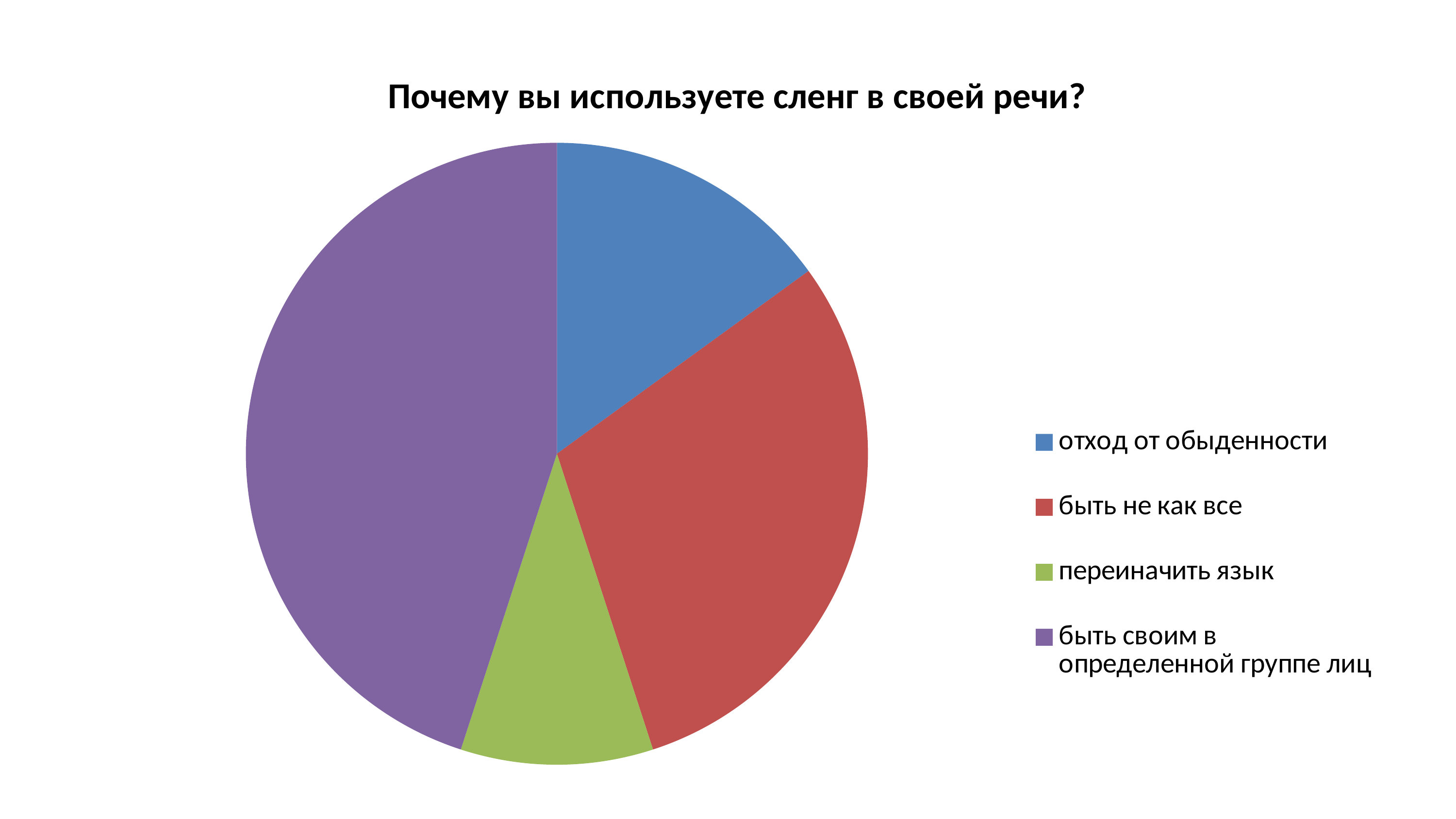
What is the title of the chart? Почему вы используете сленг в своей речи? What colour is the slice for "переиначить язык"? green How many slices does the pie chart have? 4 How many entries does the legend list? 4 Which category has the smallest slice of the pie? переиначить язык What kind of chart is shown on the slide? pie chart Which slice is larger: "быть не как все" or "отход от обыденности"? быть не как все Which category has the largest slice of the pie? быть своим в определенной группе лиц Which slice is larger: "отход от обыденности" or "переиначить язык"? отход от обыденности Which slice is larger: "быть своим в определенной группе лиц" or "быть не как все"? быть своим в определенной группе лиц